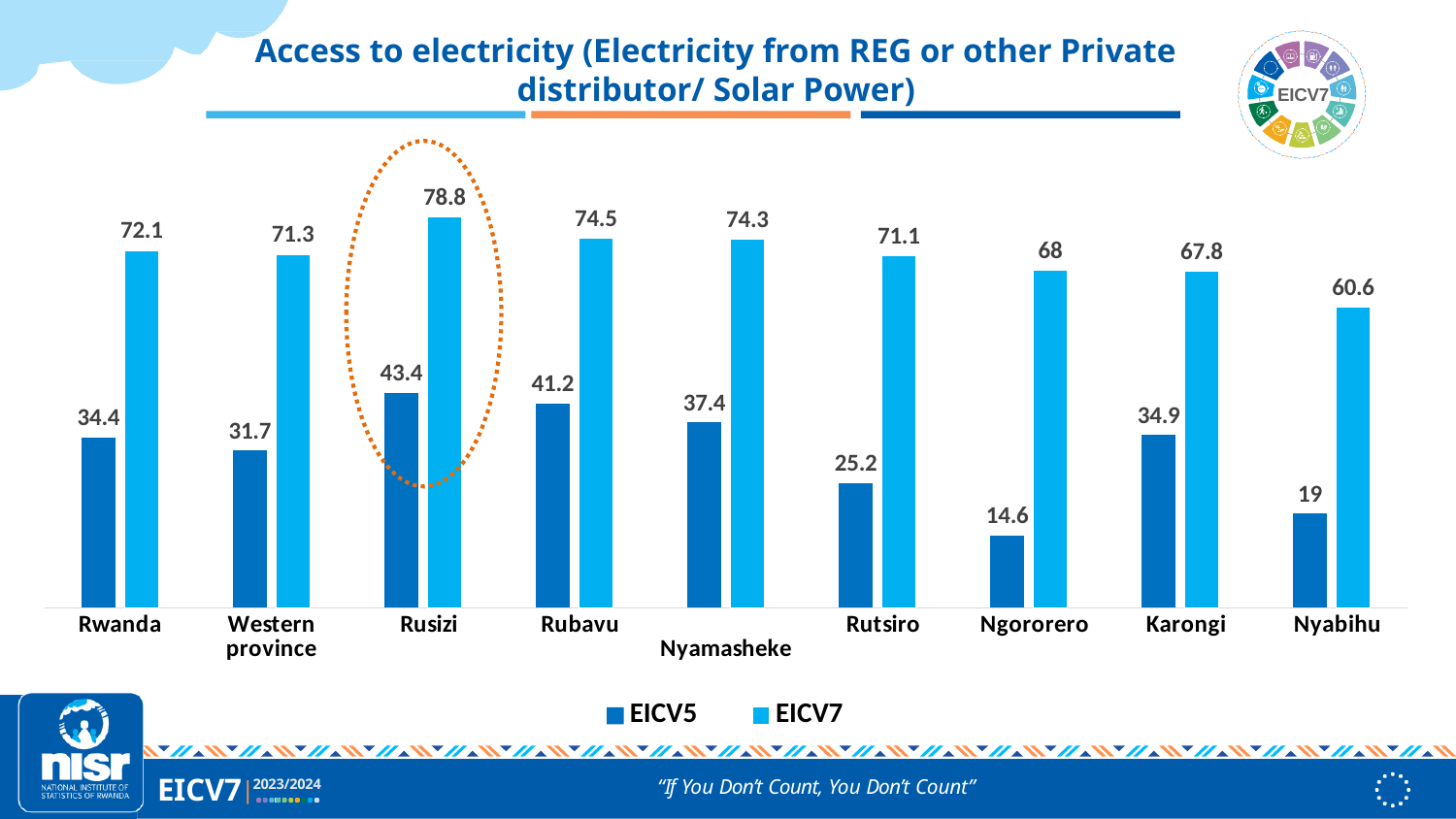
What kind of chart is shown on the slide? Bar chart Which category has the highest EICV7 value? Rusizi Which category has the lowest EICV5 value? Ngororero What is the EICV7 value for Nyabihu? 60.6 What is the difference between the EICV7 and EICV5 values for Rwanda? 37.7 How many series does the legend list? 2 What is the EICV5 value for Ngororero? 14.6 What are the two series named in the legend? EICV5 and EICV7 Which is larger, the EICV5 value for Rubavu or the EICV5 value for Nyamasheke? Rubavu Which category is highlighted with a dotted orange circle? Rusizi What is the EICV7 value for Rusizi? 78.8 How many categories are shown on the x axis? 9